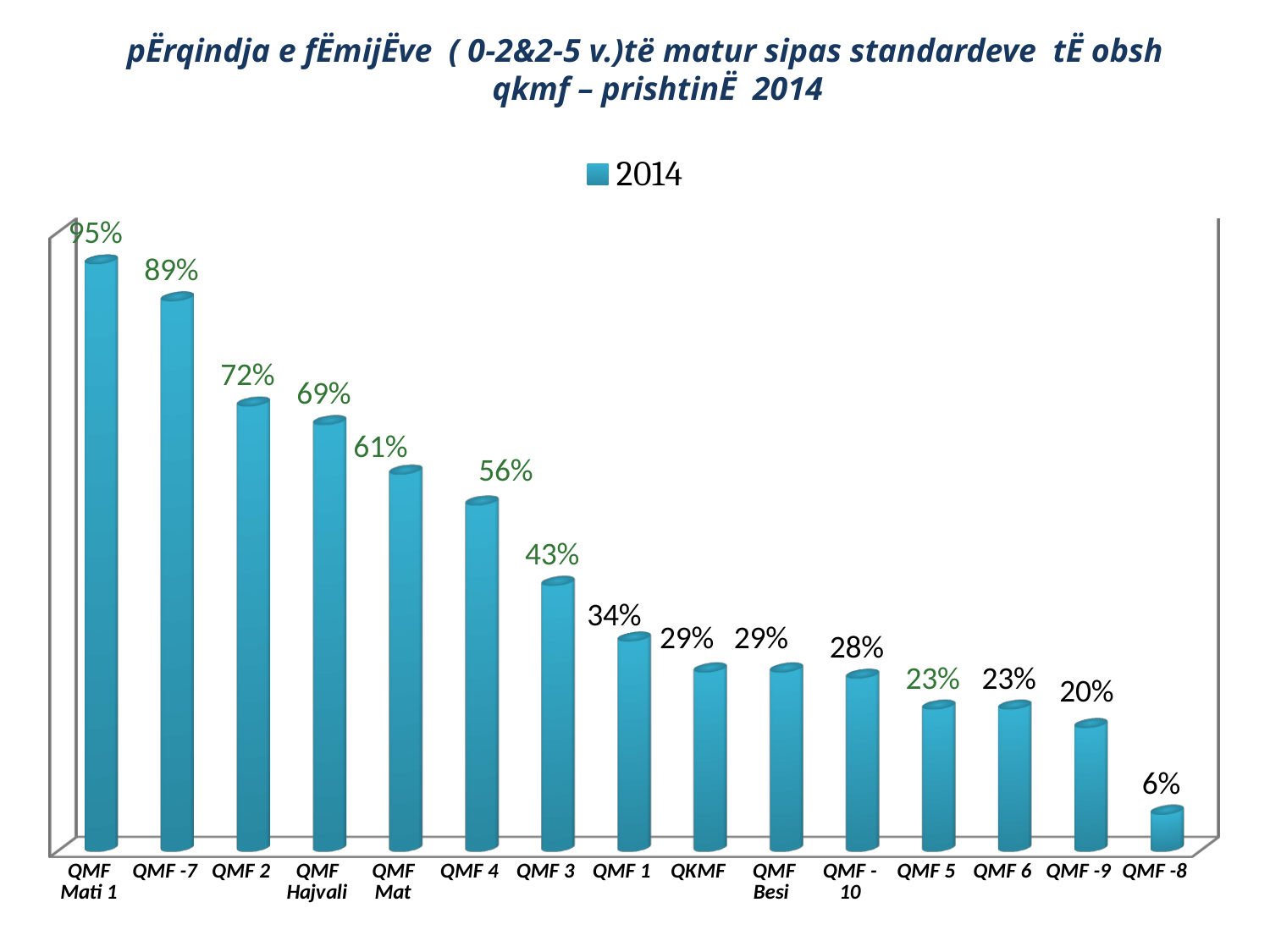
How many categories are shown on the x axis? 15 What kind of chart is shown on the slide? Bar chart What is the difference between the values for QMF -7 and QMF 2? 17% Which category has the highest value? QMF Mati 1 Which is larger, the value for QMF 4 or the value for QMF 1? QMF 4 What is the value for QMF -8? 6% Do the values rise or fall from left to right along the x axis? Fall How many series does the legend list? 1 What is the value for QMF 3? 43% What is the value for QMF Mati 1? 95% Which category has the lowest value? QMF -8 What is the value for QMF Hajvali? 69%